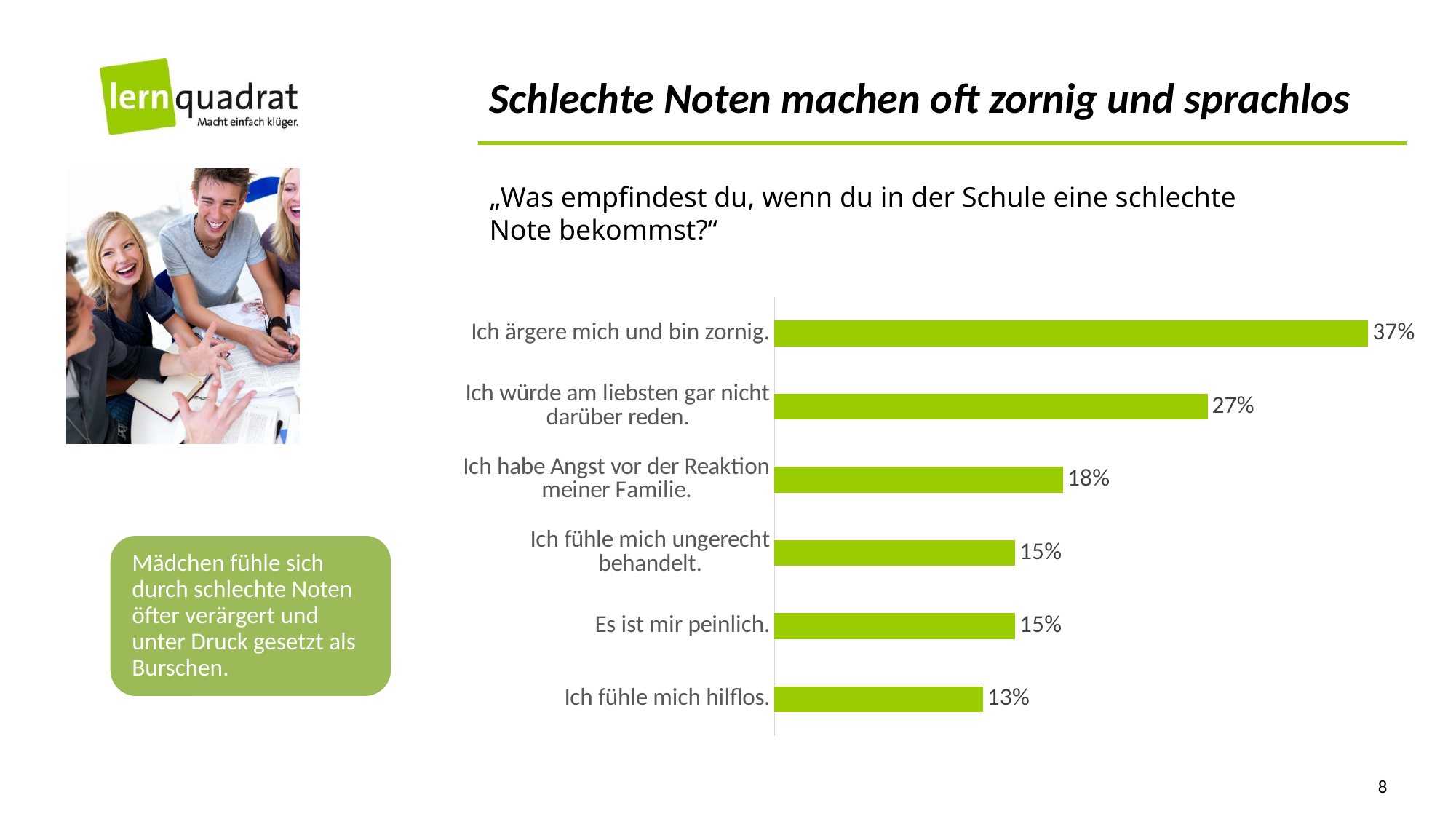
What is the value for "Ich fühle mich hilflos."? 13% Which two responses share the same value of 15%? Ich fühle mich ungerecht behandelt. and Es ist mir peinlich. Which response has the lowest percentage? Ich fühle mich hilflos. What type of chart is shown on the slide? Bar chart What is the value for "Ich würde am liebsten gar nicht darüber reden."? 27% How many response categories are shown in the chart? 6 What percentage of respondents answered "Ich ärgere mich und bin zornig."? 37% What is the value for "Ich habe Angst vor der Reaktion meiner Familie."? 18% Which response has the highest percentage? Ich ärgere mich und bin zornig. Which is larger: the value for "Ich habe Angst vor der Reaktion meiner Familie." or for "Es ist mir peinlich."? Ich habe Angst vor der Reaktion meiner Familie. What colour are the bars in the chart? Green What is the difference in percentage points between "Ich ärgere mich und bin zornig." and "Ich würde am liebsten gar nicht darüber reden."? 10 percentage points